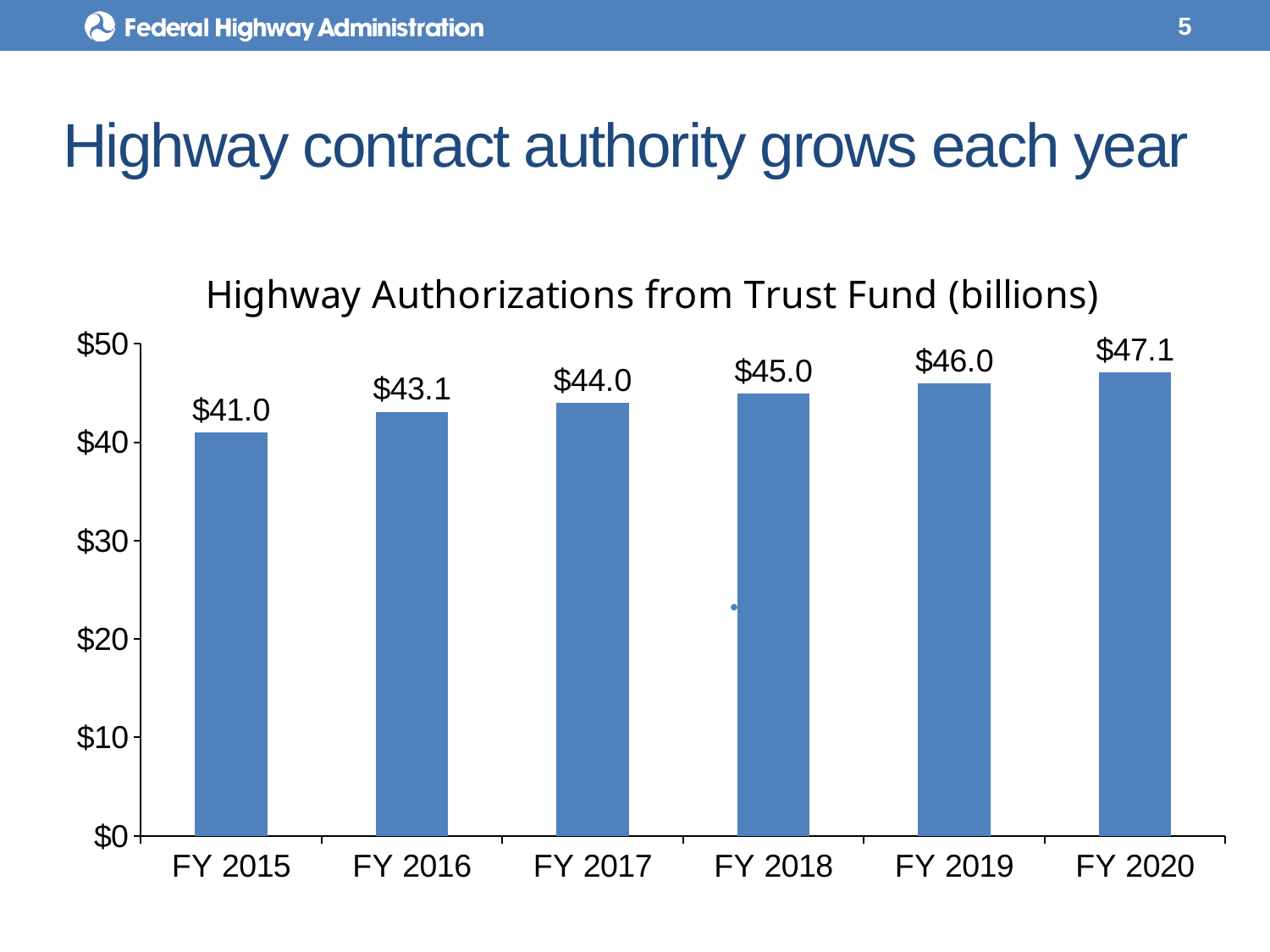
Which fiscal year has the highest authorization? FY 2020 Do the values rise or fall from FY 2015 to FY 2020? Rise What is the difference between the FY 2020 and FY 2015 values? $6.1 What is the difference between the FY 2016 and FY 2015 values? $2.1 What is the value for FY 2018? $45.0 Which is larger, the value for FY 2017 or FY 2019? FY 2019 Is the value for FY 2016 greater or less than $40? greater What is the value for FY 2020? $47.1 How many fiscal years are shown on the chart? 6 What kind of chart is shown on the slide? Bar chart Which fiscal year has the lowest authorization? FY 2015 What is the value for FY 2015? $41.0